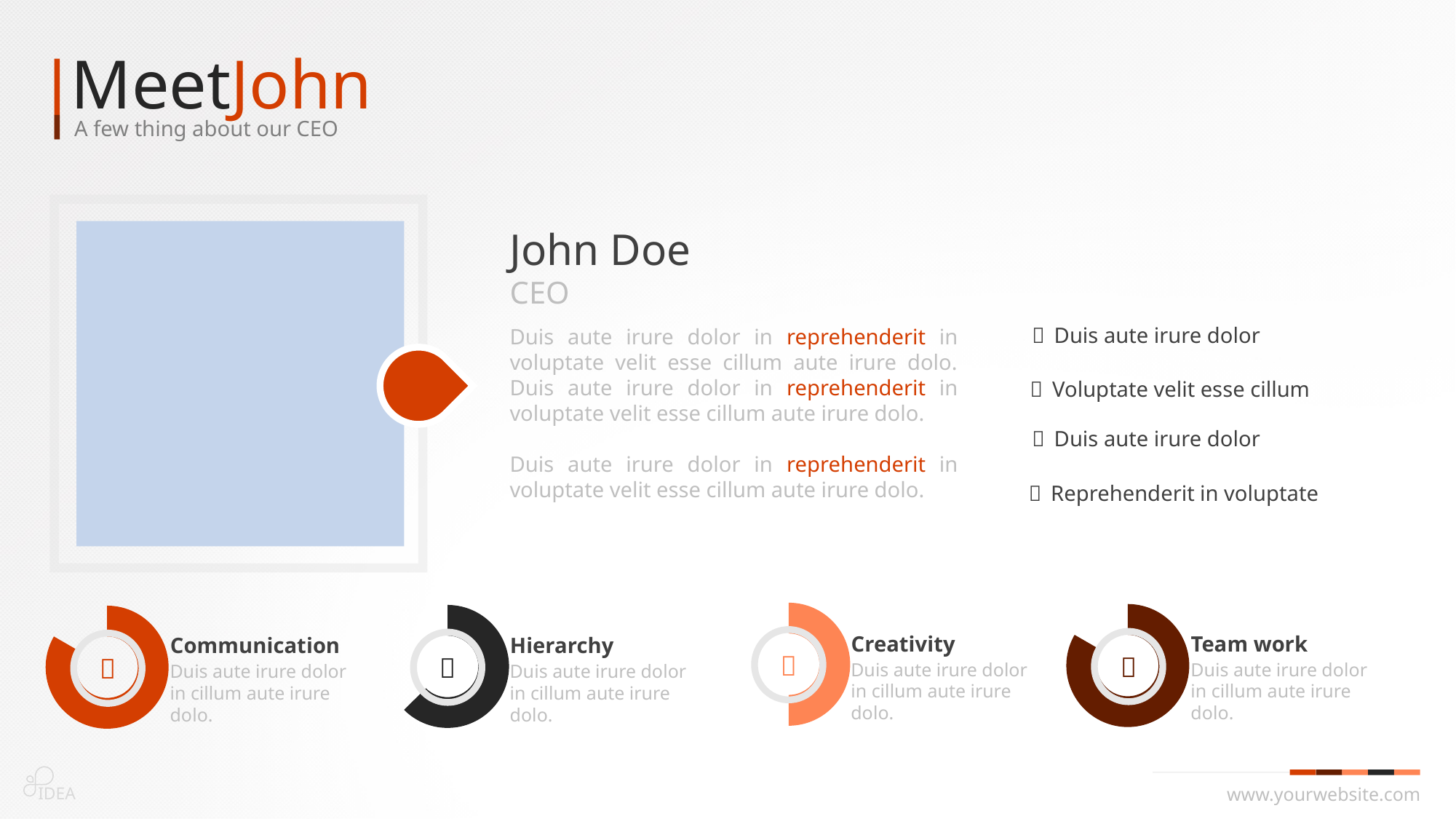
What is the label of the ring chart on the far right? Team work What kind of chart is used for the Communication, Hierarchy, Creativity and Team work indicators? doughnut chart Is the Communication ring filled more or less than half? more How many ring charts are shown along the bottom of the slide? 4 What is the label of the first ring chart on the left? Communication Is the Creativity ring filled more or less than three quarters? less Which ring chart is more filled, Communication or Hierarchy? Communication Which ring chart is more filled, Team work or Creativity? Team work